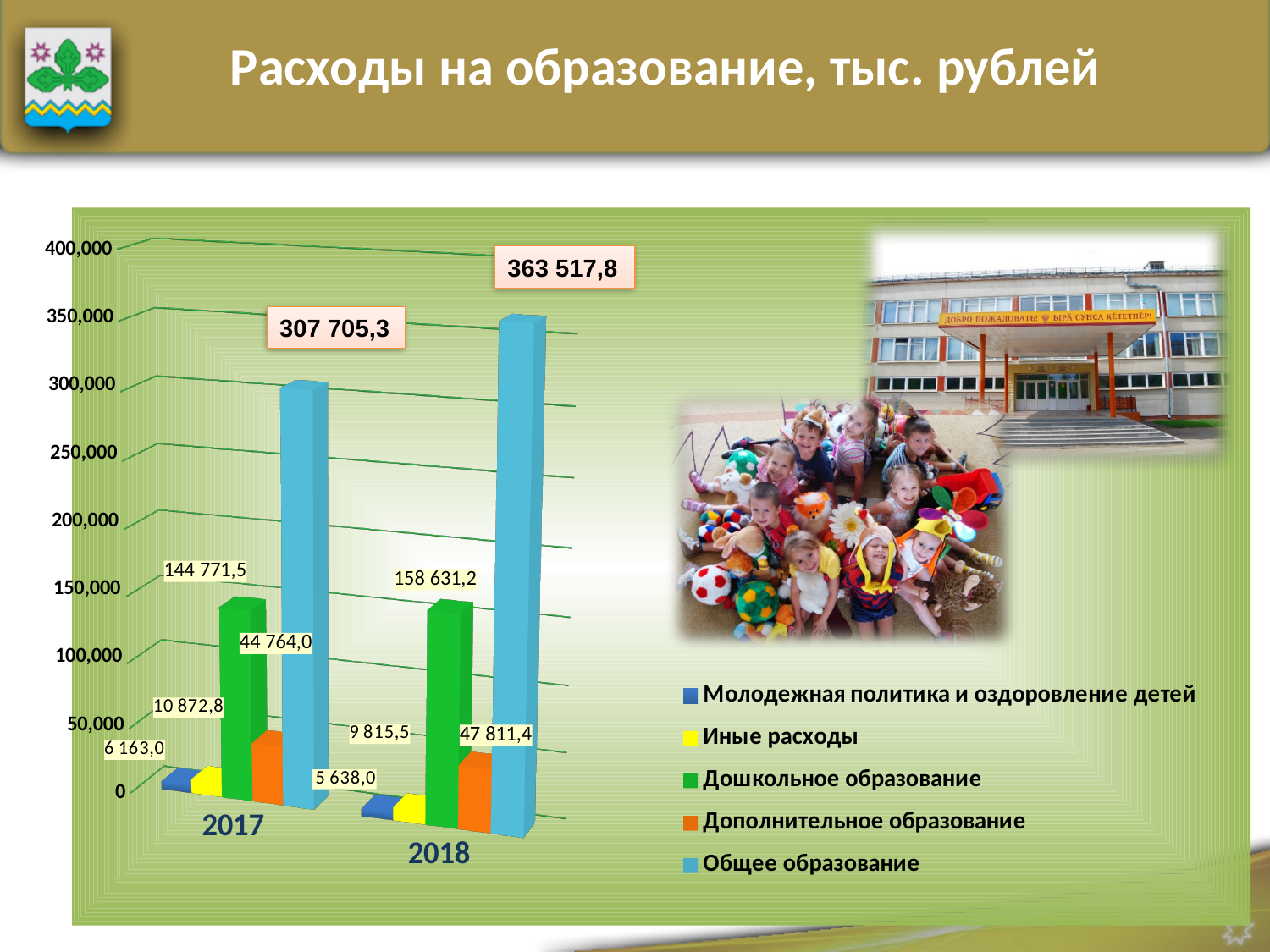
What is the value for Дополнительное образование in 2018? 47 811,4 Which is larger: Дошкольное образование in 2017 or in 2018? 2018 What is the value for Дошкольное образование in 2017? 144 771,5 What is the value for Иные расходы in 2018? 9 815,5 What is the value for Молодежная политика и оздоровление детей in 2017? 6 163,0 How many series does the legend list? 5 What kind of chart is shown on the slide? Bar chart By how much did Общее образование increase from 2017 to 2018? 55 812,5 Which series has the highest value in 2018? Общее образование What is the value for Общее образование in 2018? 363 517,8 Does the value for Общее образование rise or fall from 2017 to 2018? Rise Which series has the lowest value in 2017? Молодежная политика и оздоровление детей